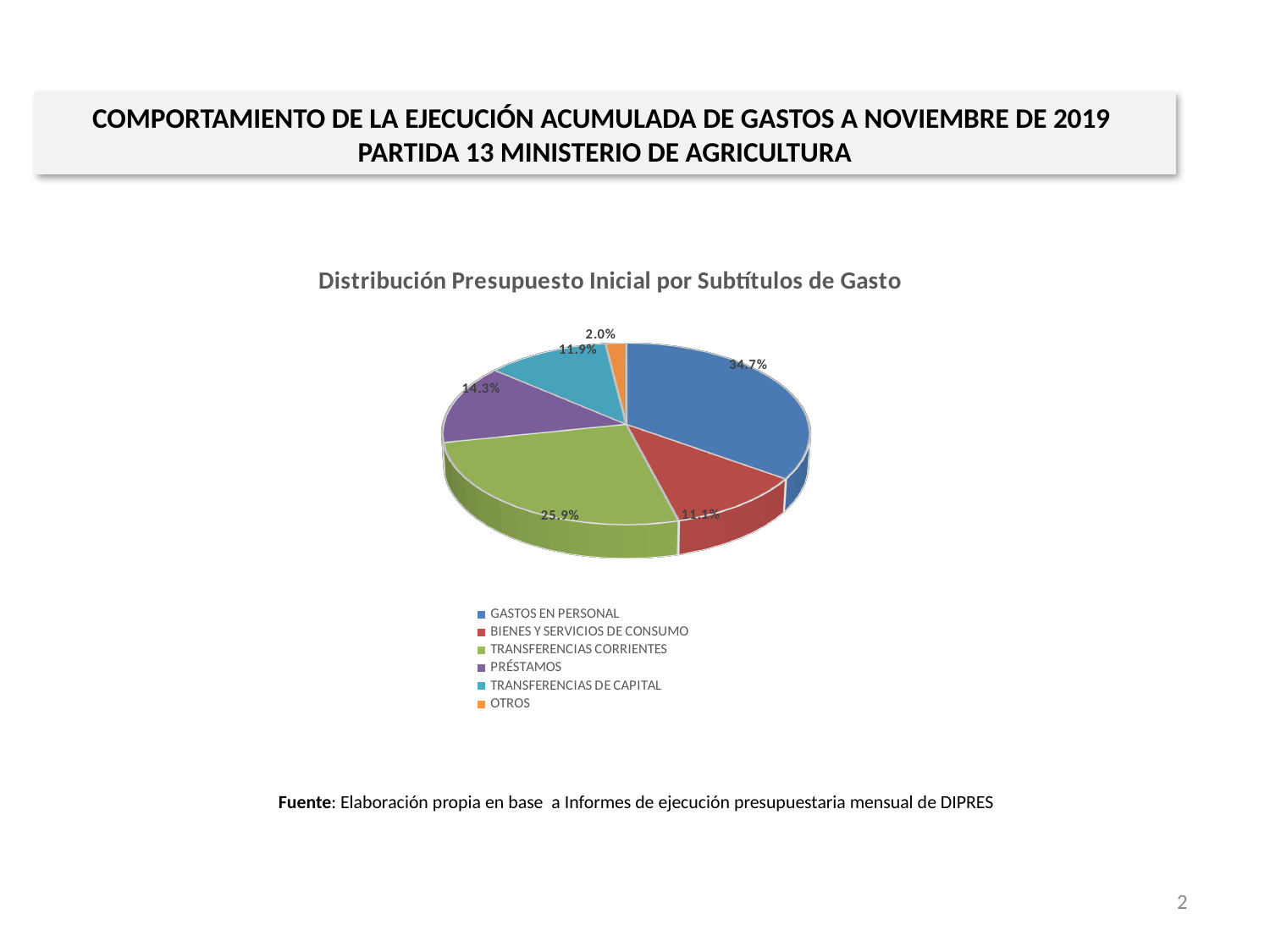
What is the title of the chart? Distribución Presupuesto Inicial por Subtítulos de Gasto Which category has the smallest share of the pie? OTROS What is the difference between the shares of GASTOS EN PERSONAL and TRANSFERENCIAS CORRIENTES? 8.8% Which is larger, the share for PRÉSTAMOS or the share for TRANSFERENCIAS DE CAPITAL? PRÉSTAMOS What is the value shown for OTROS? 2.0% Which category has the largest share of the pie? GASTOS EN PERSONAL How many series does the legend list? 6 What is the value shown for BIENES Y SERVICIOS DE CONSUMO? 11.1% What share of the pie does TRANSFERENCIAS CORRIENTES represent? 25.9% What kind of chart is shown on the slide? Pie chart What share of the pie does GASTOS EN PERSONAL represent? 34.7% What is the value shown for PRÉSTAMOS? 14.3%